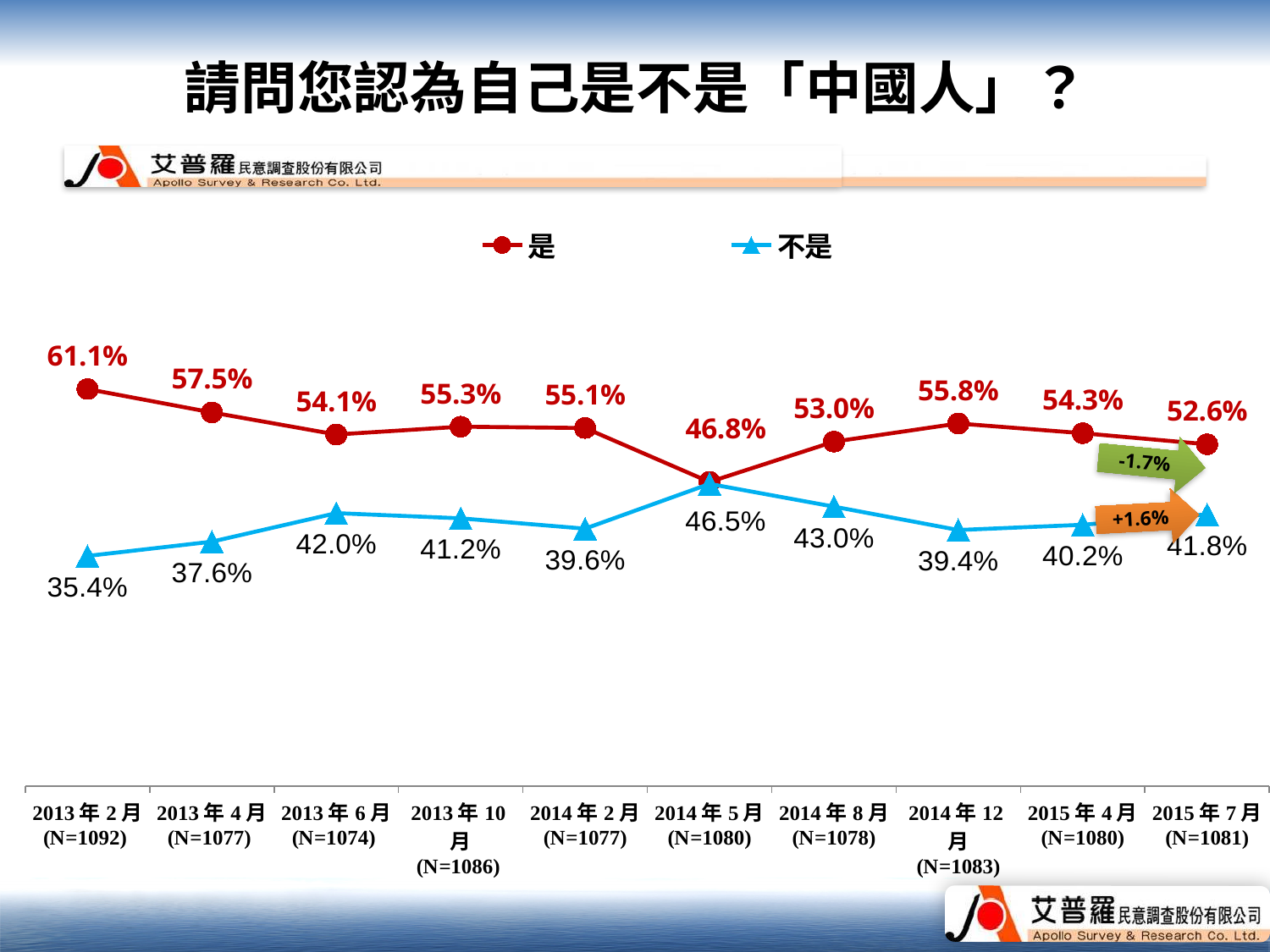
How many series does the legend list? 2 Which is larger for 2014年12月, 是 or 不是? 是 What is the difference between 是 and 不是 for 2015年7月? 10.8% At which survey date is the 不是 series highest? 2014年5月 What is the value of 是 for 2013年2月? 61.1% How many survey dates are plotted along the x axis? 10 What is the value of 不是 for 2015年7月? 41.8% At which survey date is the 不是 series lowest? 2013年2月 What kind of chart is shown on the slide? line chart What colour is the line for the 不是 series? blue At which survey date is the 是 series highest? 2013年2月 What is the value of 是 for 2014年5月? 46.8%